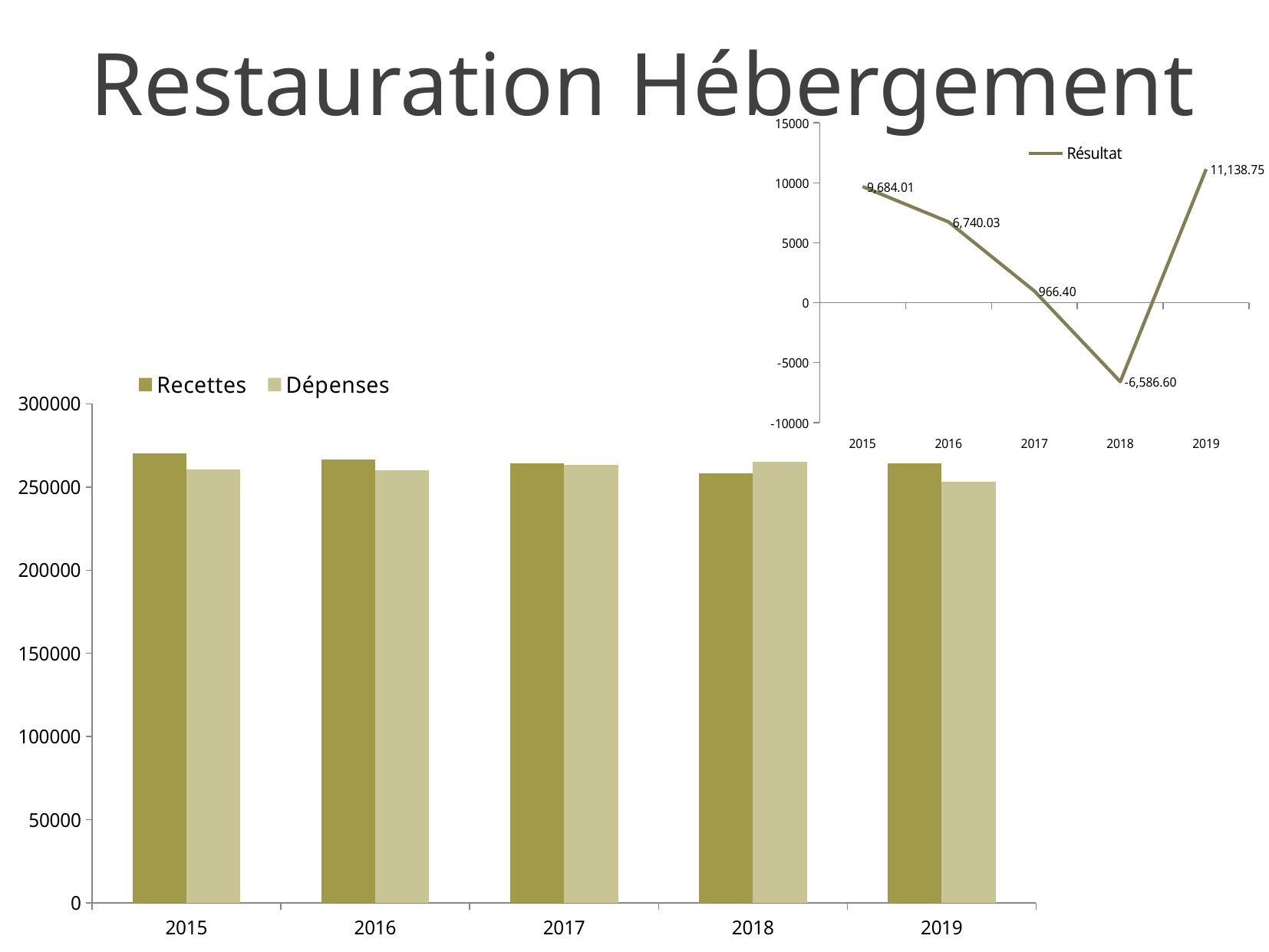
What kind of chart is the large chart at the bottom left of the slide? bar chart In the line chart (Résultat), does the value rise or fall from 2015 to 2018? fall In the line chart (Résultat), what is the value for 2019? 11,138.75 In the line chart (Résultat), what is the value for 2018? -6,586.60 In the line chart (Résultat), which year has the lowest value? 2018 In the line chart (Résultat), which year has the highest value? 2019 In the bar chart (Recettes / Dépenses), how many years are shown on the x axis? 5 In the bar chart (Recettes / Dépenses), is the Recettes value for 2015 greater or less than 250000? greater In the bar chart (Recettes / Dépenses), how many series does the legend list? 2 In the bar chart (Recettes / Dépenses), which is larger for 2018, Recettes or Dépenses? Dépenses In the line chart (Résultat), what is the difference between the 2015 value and the 2016 value? 2,943.98 In the line chart (Résultat), what is the value for 2017? 966.40